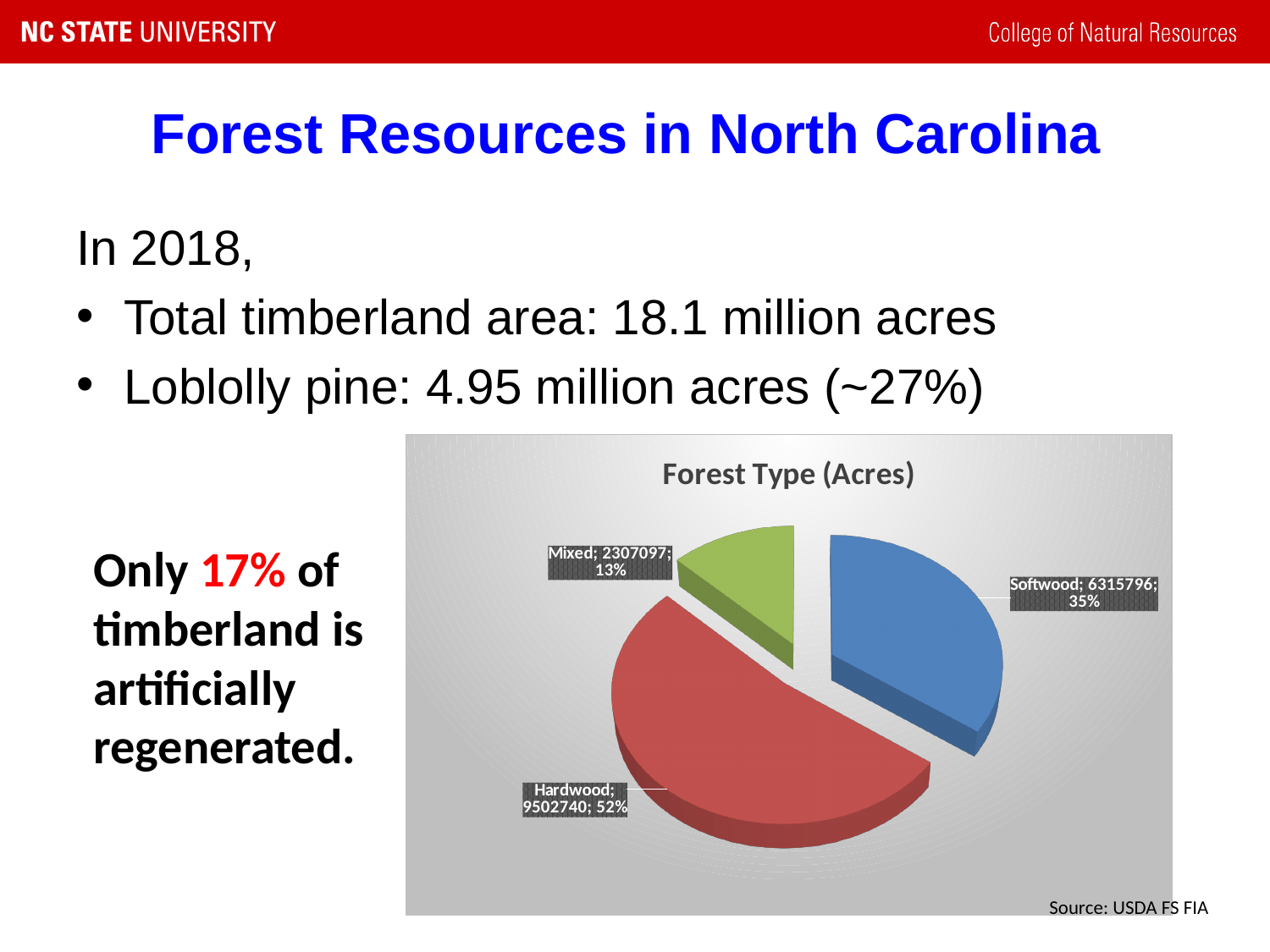
Which forest type has the largest slice of the pie? Hardwood What is the difference in acres between Hardwood and Softwood? 3186944 What share of the pie does Softwood represent? 35% What share of the pie does Hardwood represent? 52% What is the value for Mixed in the pie chart? 2307097 What is the value for Softwood in the pie chart? 6315796 What is the value for Hardwood in the pie chart? 9502740 What is the title of the chart? Forest Type (Acres) Which forest type has the smallest slice of the pie? Mixed What type of chart is shown on the slide? pie chart What share of the pie does Mixed represent? 13% How many slices does the pie chart have? 3